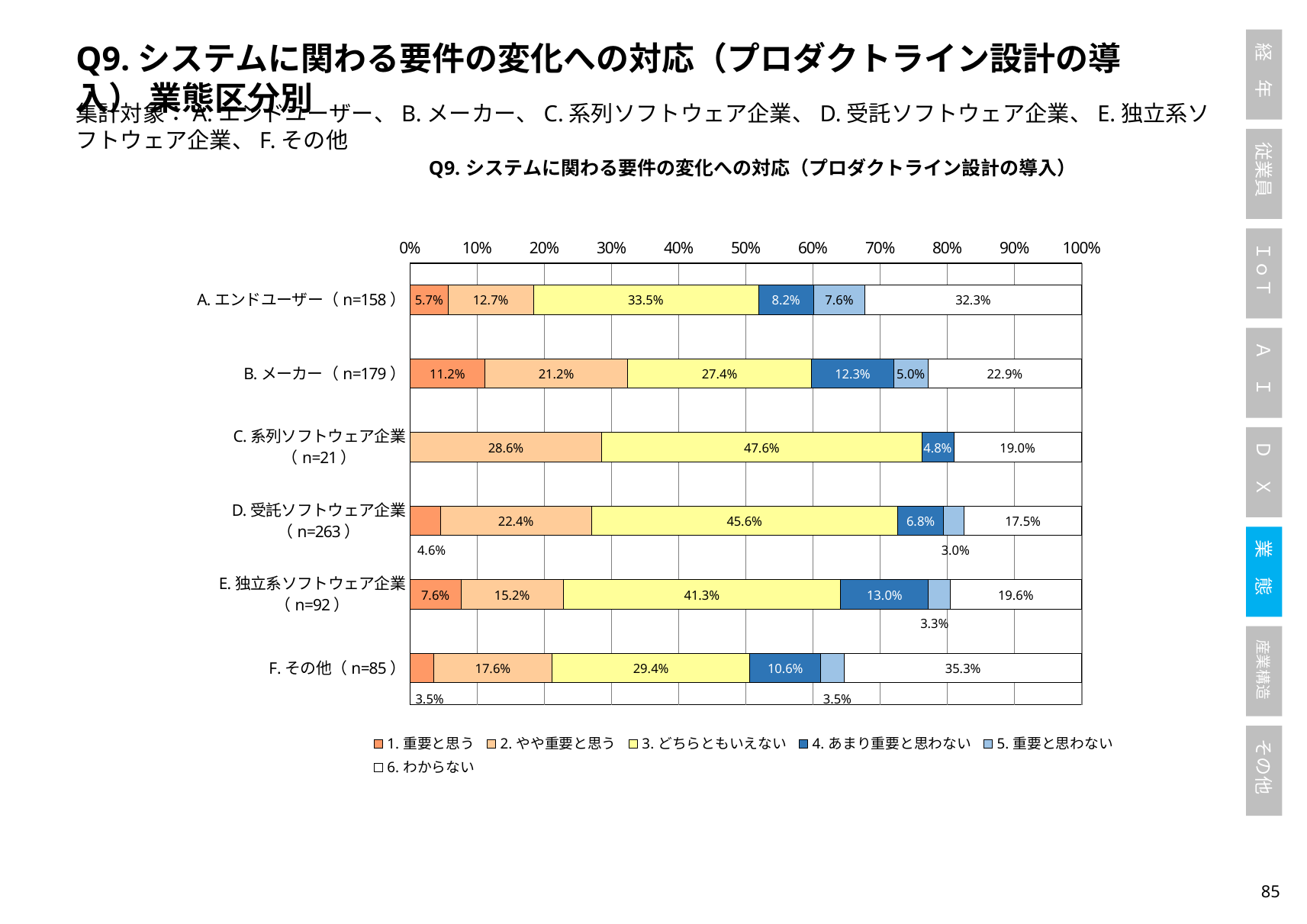
Which is larger: the 「1. 重要と思う」 value for E. 独立系ソフトウェア企業 or for D. 受託ソフトウェア企業? E. 独立系ソフトウェア企業 What is the value of 「6. わからない」 for F. その他 (n=85)? 35.3% What is the value of 「4. あまり重要と思わない」 for E. 独立系ソフトウェア企業 (n=92)? 13.0% How many series does the legend list? 6 Which category has the lowest value for 「6. わからない」? D. 受託ソフトウェア企業 (n=263) What is the difference between the 「2. やや重要と思う」 values for B. メーカー and A. エンドユーザー? 8.5% Which category has the highest value for 「3. どちらともいえない」? C. 系列ソフトウェア企業 (n=21) What kind of chart is shown on the slide? Stacked bar chart What is the sample size (n) shown for D. 受託ソフトウェア企業? 263 What is the value of 「3. どちらともいえない」 for C. 系列ソフトウェア企業 (n=21)? 47.6% How many categories (business types) are plotted on the chart? 6 What is the value of 「1. 重要と思う」 for B. メーカー (n=179)? 11.2%